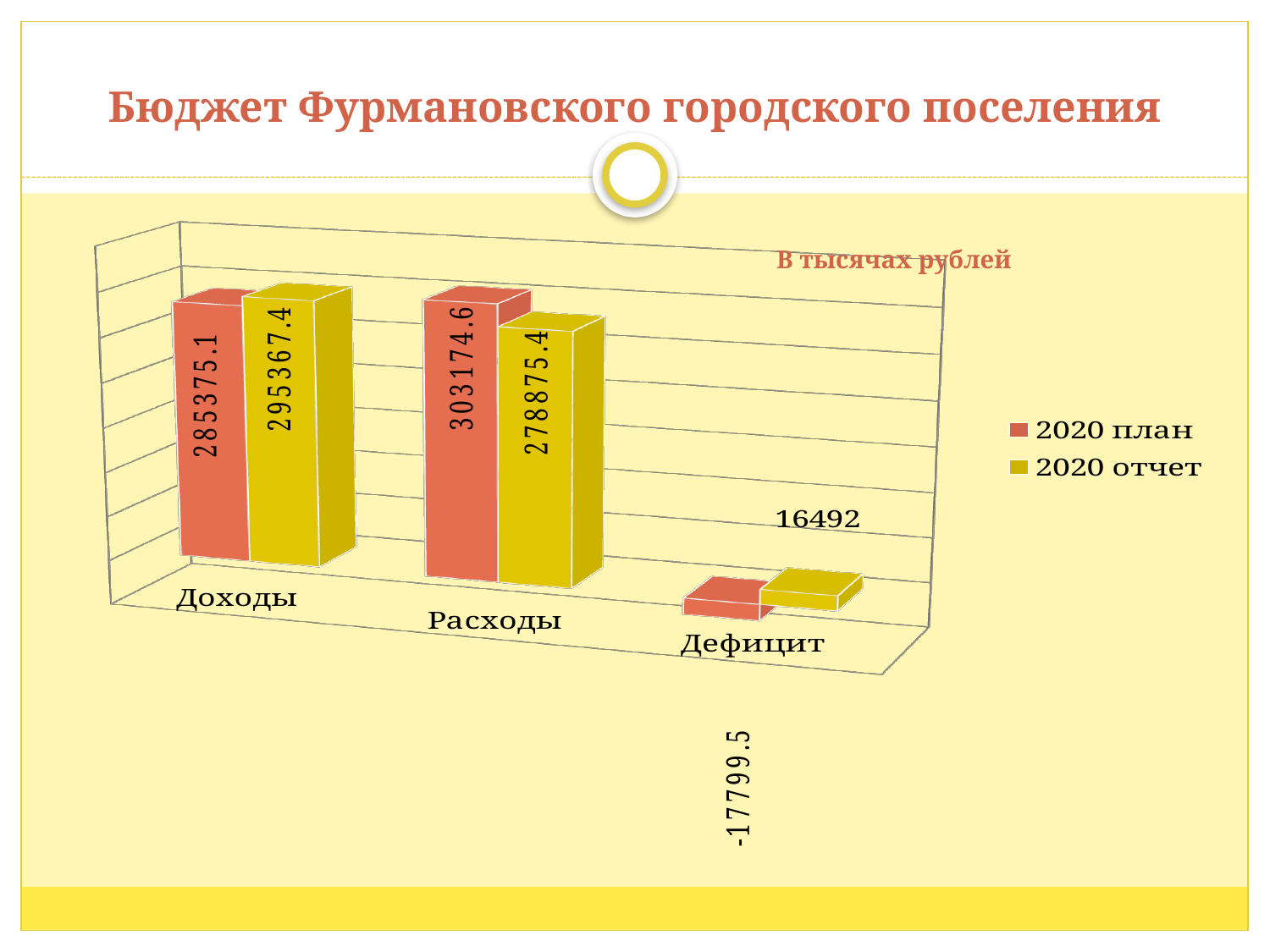
How many series does the legend list? 2 What is the value for Расходы in the 2020 отчет series? 278875.4 What is the difference between the 2020 отчет and 2020 план values for Доходы? 9992.3 What kind of chart is shown on the slide? Bar chart What is the value for Дефицит in the 2020 отчет series? 16492 What is the value for Доходы in the 2020 отчет series? 295367.4 Which category has the lowest value in the 2020 отчет series? Дефицит What is the value for Доходы in the 2020 план series? 285375.1 For Расходы, which is larger: the 2020 план value or the 2020 отчет value? 2020 план What is the value for Дефицит in the 2020 план series? -17799.5 What is the value for Расходы in the 2020 план series? 303174.6 Which category has the highest value in the 2020 план series? Расходы